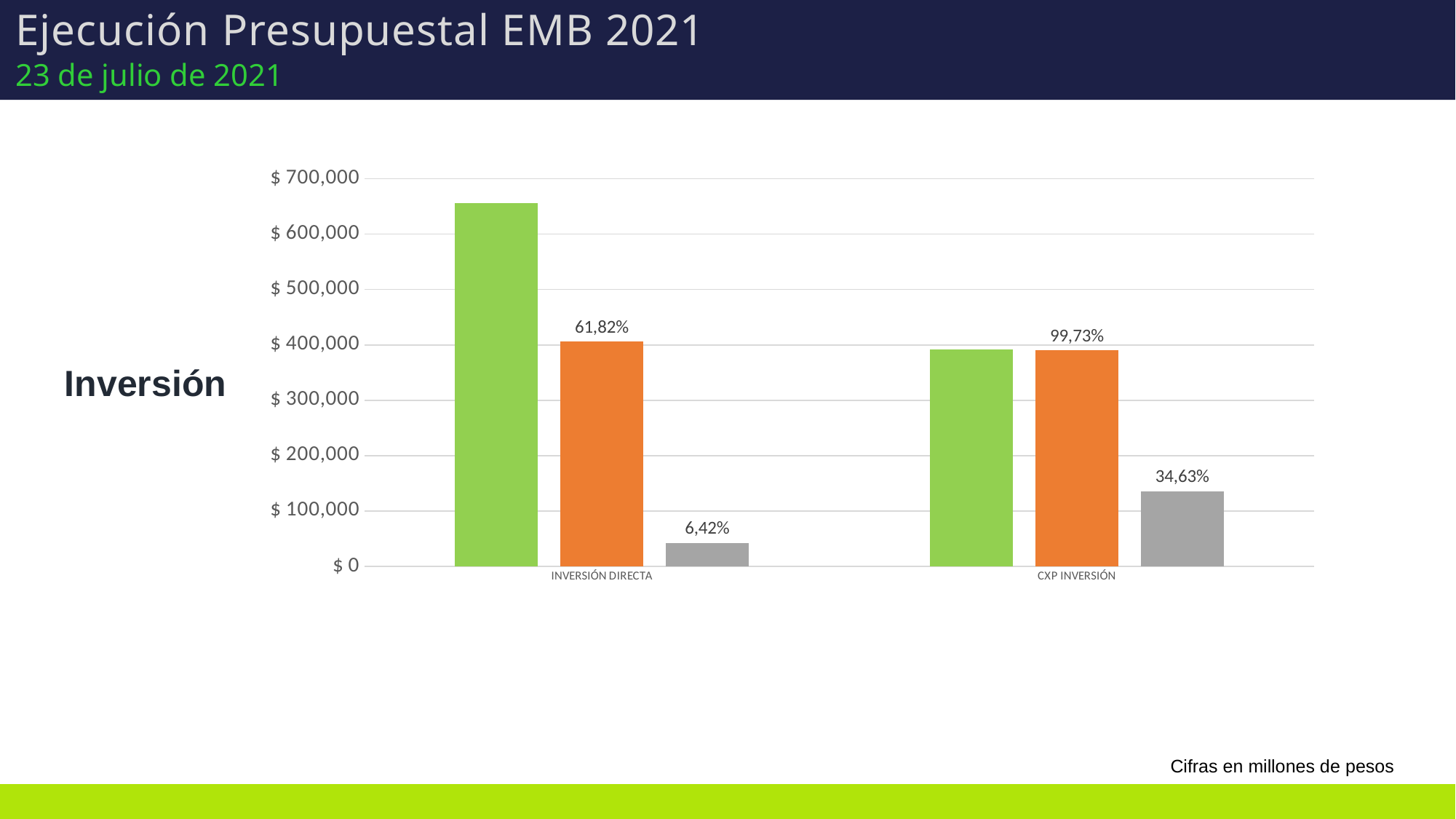
What kind of chart is shown on the slide? bar chart What is the title of the slide containing the chart? Ejecución Presupuestal EMB 2021 Which percentage label on the chart is the lowest? 6,42% What percentage is labelled on the orange bar for INVERSIÓN DIRECTA? 61,82% Is the value of the grey bar for CXP INVERSIÓN greater or less than $ 100,000? greater How many categories are shown on the x axis of the chart? 2 What percentage is labelled on the orange bar for CXP INVERSIÓN? 99,73% Which category has the highest percentage label on its orange bar? CXP INVERSIÓN Is the value of the green bar for INVERSIÓN DIRECTA greater or less than $ 600,000? greater What percentage is labelled on the grey bar for INVERSIÓN DIRECTA? 6,42% What percentage is labelled on the grey bar for CXP INVERSIÓN? 34,63% Which green bar is taller, the one for INVERSIÓN DIRECTA or the one for CXP INVERSIÓN? INVERSIÓN DIRECTA